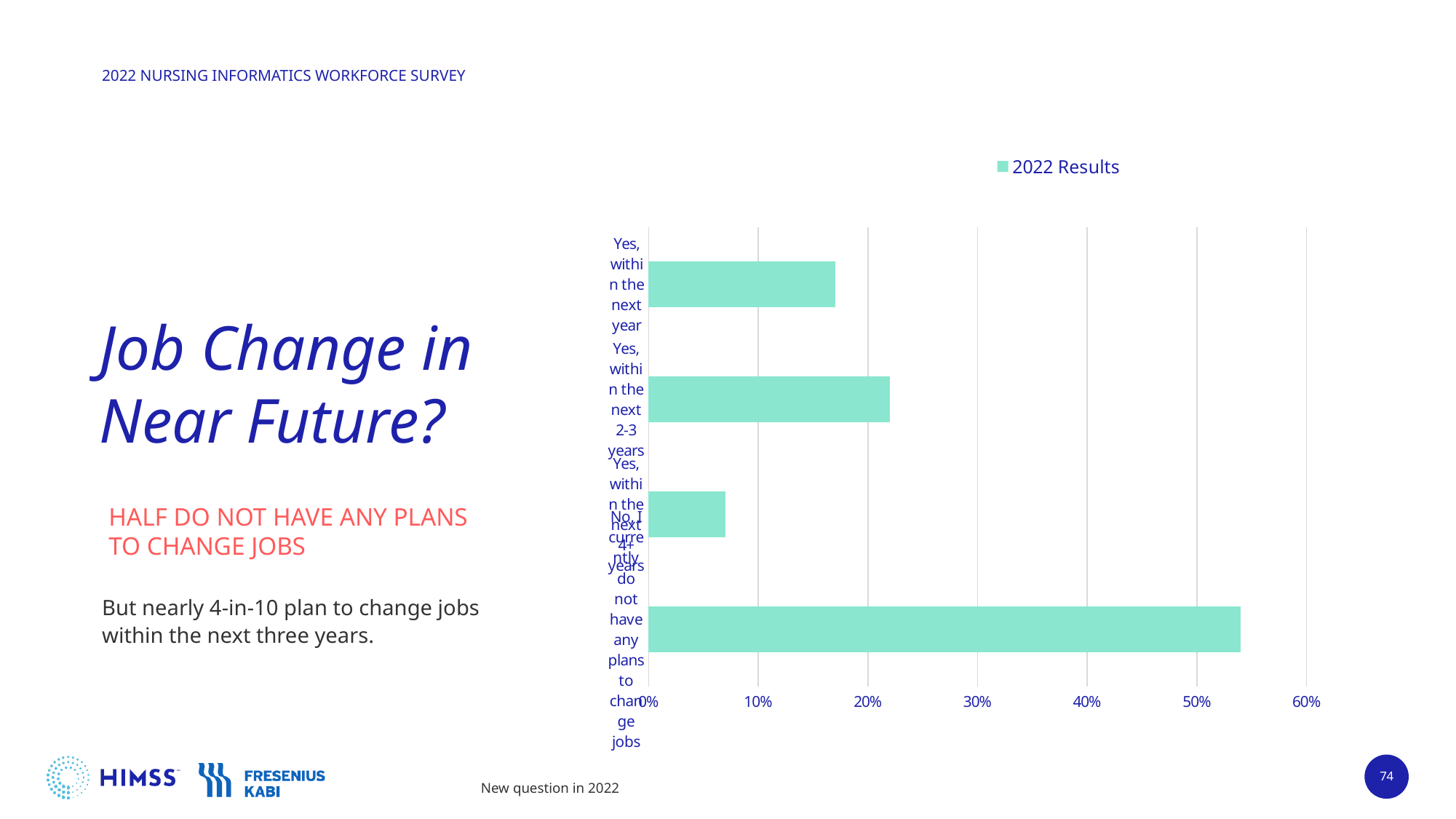
Is the value for "Yes, within the next 2-3 years" greater or less than 20%? greater Which category has the highest value? No, I currently do not have any plans to change jobs Is the value for "Yes, within the next 4+ years" greater or less than 10%? less Which category has the lowest value? Yes, within the next 4+ years What kind of chart is shown on the slide? bar chart What is the highest value shown on the x axis of the chart? 60% Which is larger: the value for "Yes, within the next year" or "Yes, within the next 2-3 years"? Yes, within the next 2-3 years Is the value for "Yes, within the next year" greater or less than 20%? less How many series does the legend list? 1 How many categories are plotted in the chart? 4 What is the name of the series shown in the legend? 2022 Results